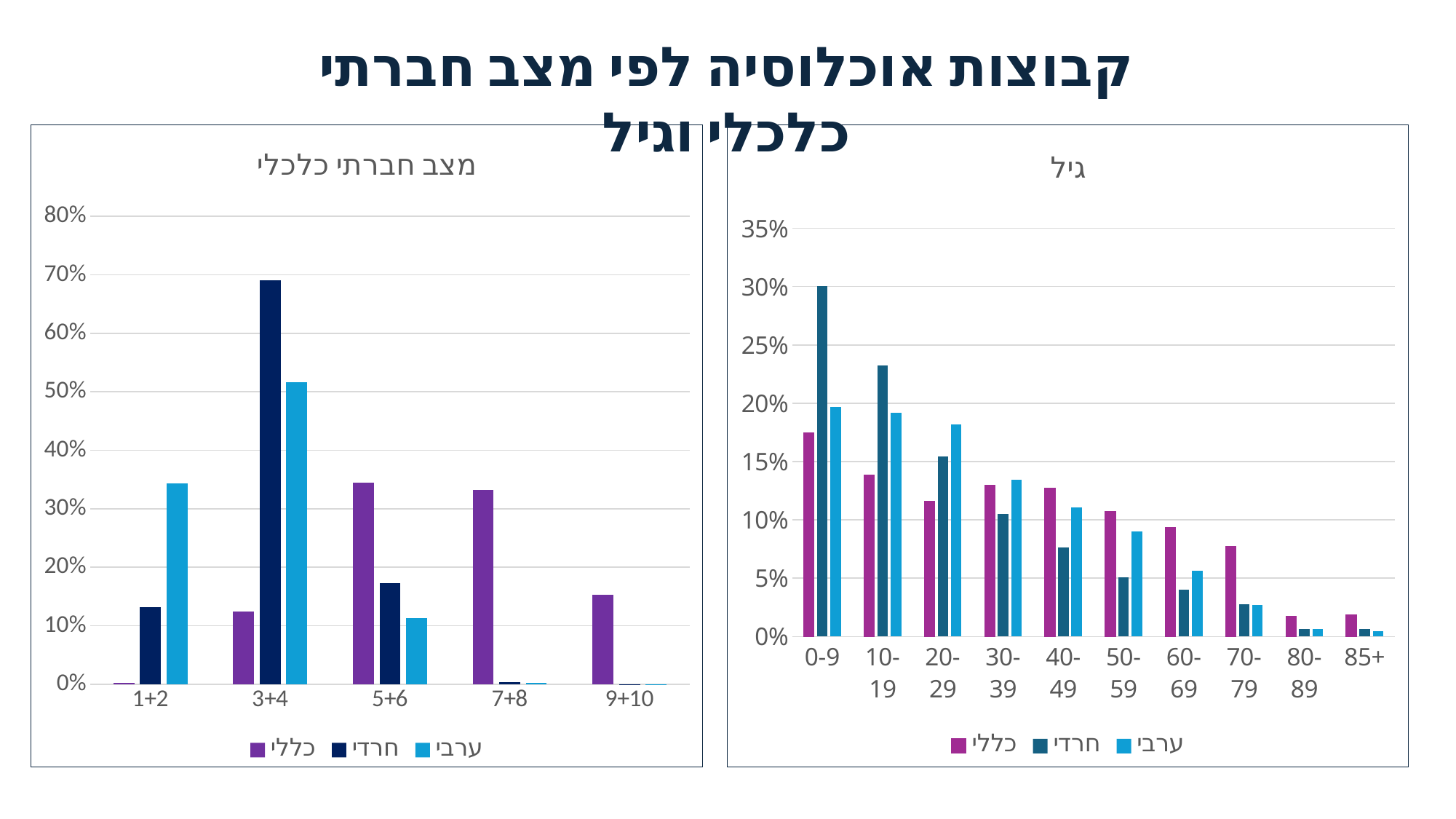
In the left chart titled מצב חברתי כלכלי, is the value for חרדי at 3+4 greater or less than 60%? greater In the right chart titled גיל, which age group has the highest value for the חרדי series? 0-9 In the right chart titled גיל, do the values for the כללי series rise or fall as age increases from 0-9 to 85+? fall How many categories are shown on the x axis of the left chart titled מצב חברתי כלכלי? 5 In the right chart titled גיל, is the value for חרדי at 0-9 greater or less than 25%? greater How many series does the legend of the right chart titled גיל list? 3 In the left chart titled מצב חברתי כלכלי, which category has the highest value for the חרדי series? 3+4 In the left chart titled מצב חברתי כלכלי, is the value for ערבי at 1+2 greater or less than 30%? greater How many categories are shown on the x axis of the right chart titled גיל? 10 What type of chart is the left chart titled מצב חברתי כלכלי? bar chart In the left chart titled מצב חברתי כלכלי, which is larger at 5+6: כללי or חרדי? כללי In the right chart titled גיל, which is larger at 30-39: חרדי or ערבי? ערבי